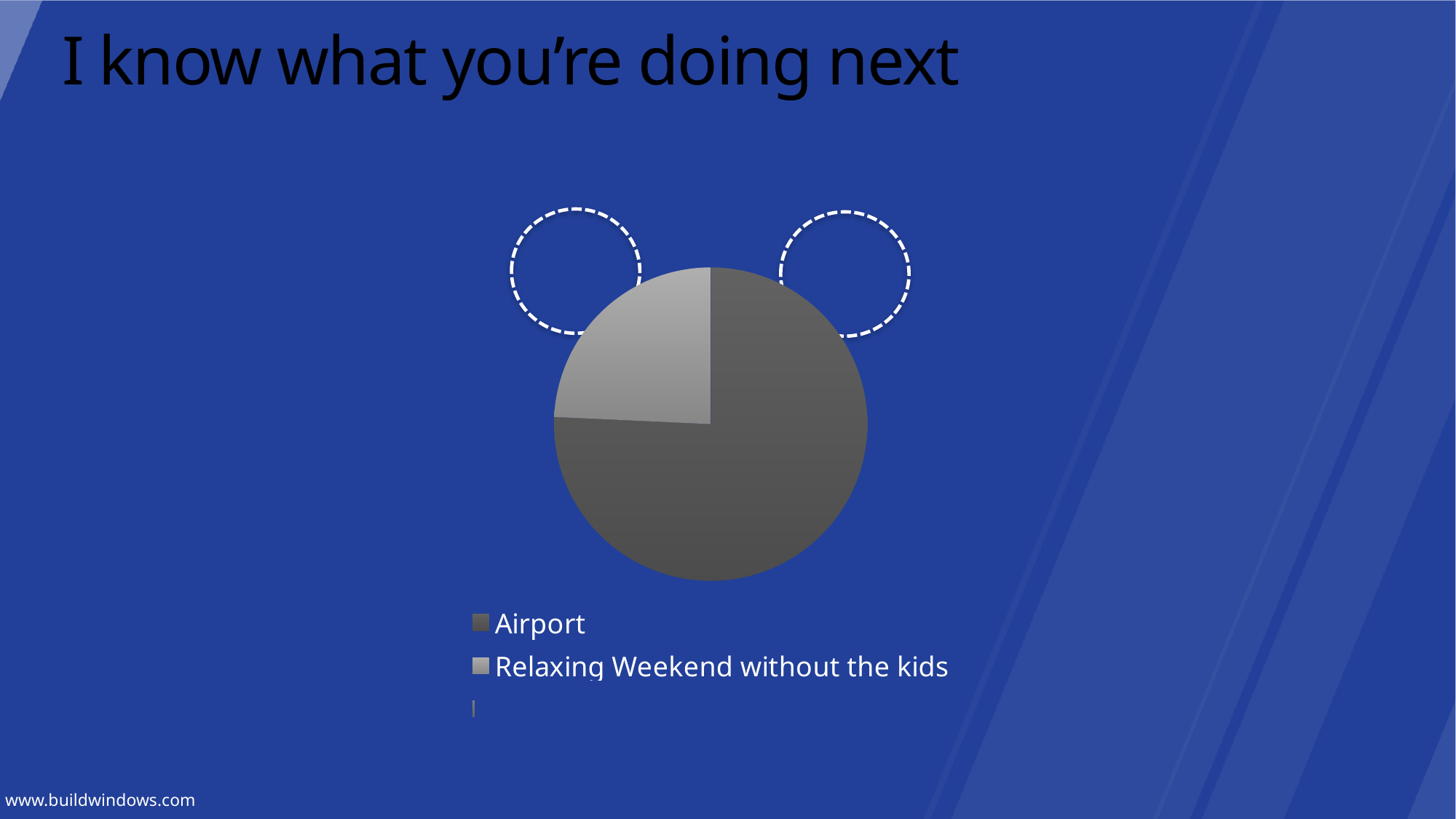
How many labelled entries does the legend list? 2 What kind of chart is shown on the slide? pie chart How many slices does the pie chart have? 2 Which legend entry is shown with the lighter grey colour? Relaxing Weekend without the kids Which category has the smallest slice of the pie? Relaxing Weekend without the kids What is the title of the slide containing the pie chart? I know what you're doing next Which category has the largest slice of the pie? Airport Which slice is larger, Airport or Relaxing Weekend without the kids? Airport